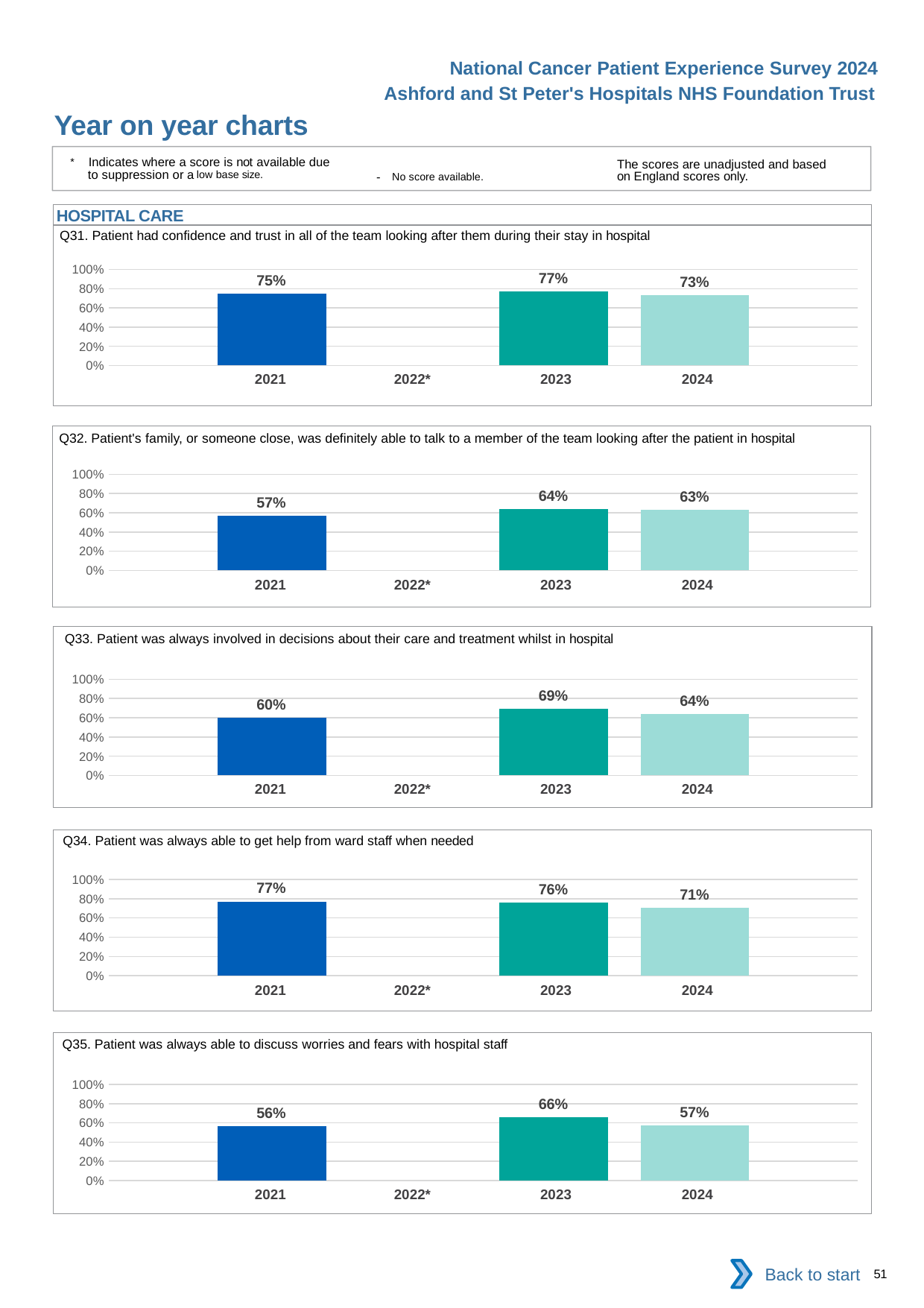
In the Q32 chart, what is the difference between the 2023 and 2021 values? 7 percentage points In the Q31 chart, what is the value for 2024? 73% In the Q35 chart, what is the difference between the 2023 and 2024 values? 9 percentage points In the Q35 chart, what is the value for 2023? 66% What kind of chart is the Q31 chart? bar chart In the Q34 chart, is the value for 2021 larger or smaller than the value for 2024? larger In the Q34 chart, which year has the lowest value? 2024 In the Q33 chart, what is the value for 2024? 64% In the Q34 chart, how many years have a bar plotted? 3 In the Q33 chart, which year has the highest value? 2023 In the Q32 chart, what is the value for 2021? 57% In the Q31 chart, which year has the highest value? 2023